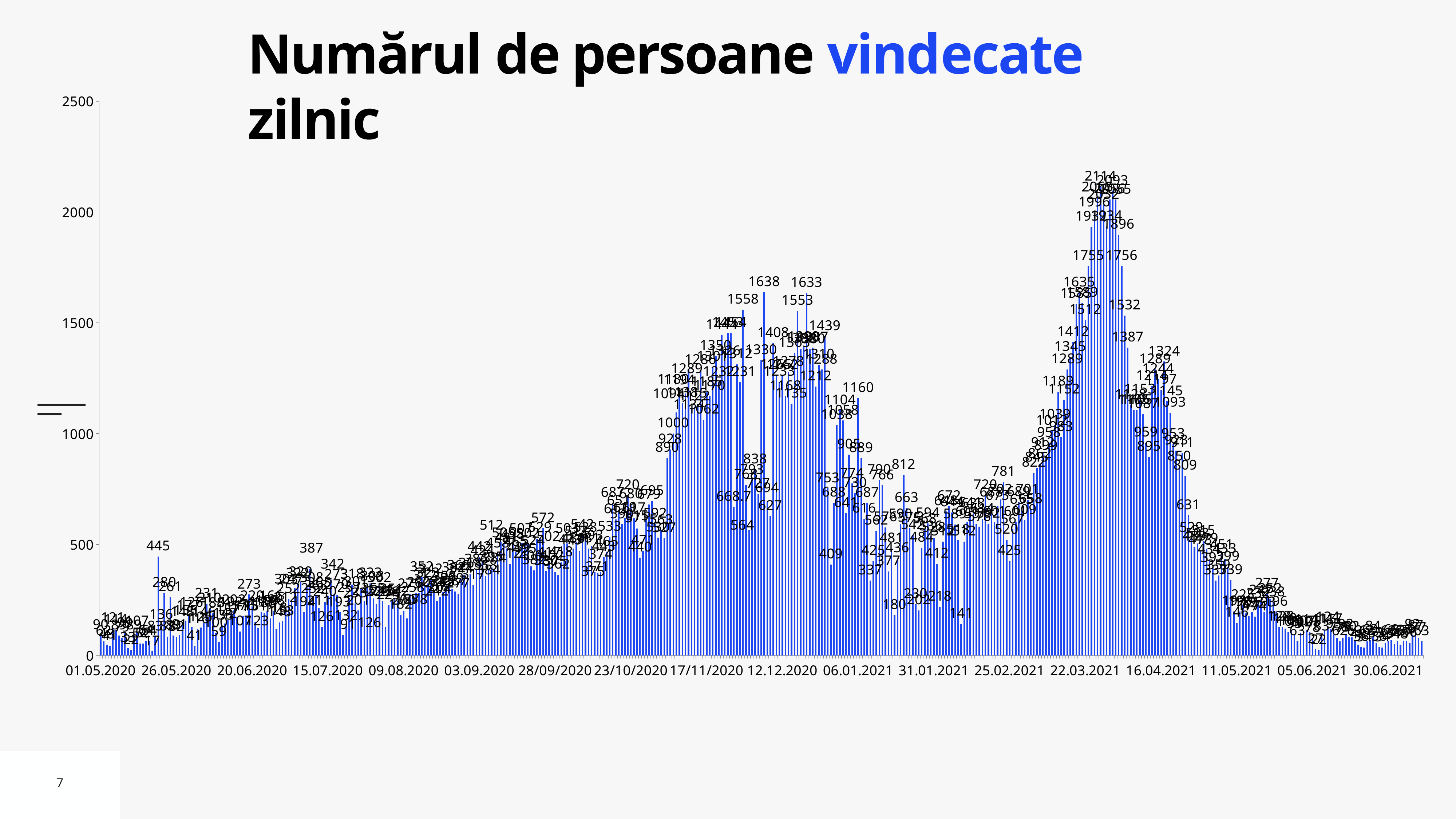
What is the highest labelled value in the peak around 12.12.2020? 1638 What is the highest tick value shown on the vertical axis? 2500 What is the highest value labelled on the chart? 2114 Is the tallest bar near 22.03.2021 greater or less than 2000? greater Is the tallest bar near 12.12.2020 greater or less than 2000? less Do the values rise or fall between 22.03.2021 and 05.06.2021? fall What kind of chart is shown on the slide? bar chart What is the difference between the highest value of the March 2021 peak (2114) and the highest value of the December 2020 peak (1638)? 476 What is the value of the tallest bar near 26.05.2020? 445 Which is larger: the peak value around 22.03.2021 (2114) or the peak value around 12.12.2020 (1638)? 2114 What is the title of the chart? Numărul de persoane vindecate zilnic Are the values around 20.06.2020 greater or less than 500? less